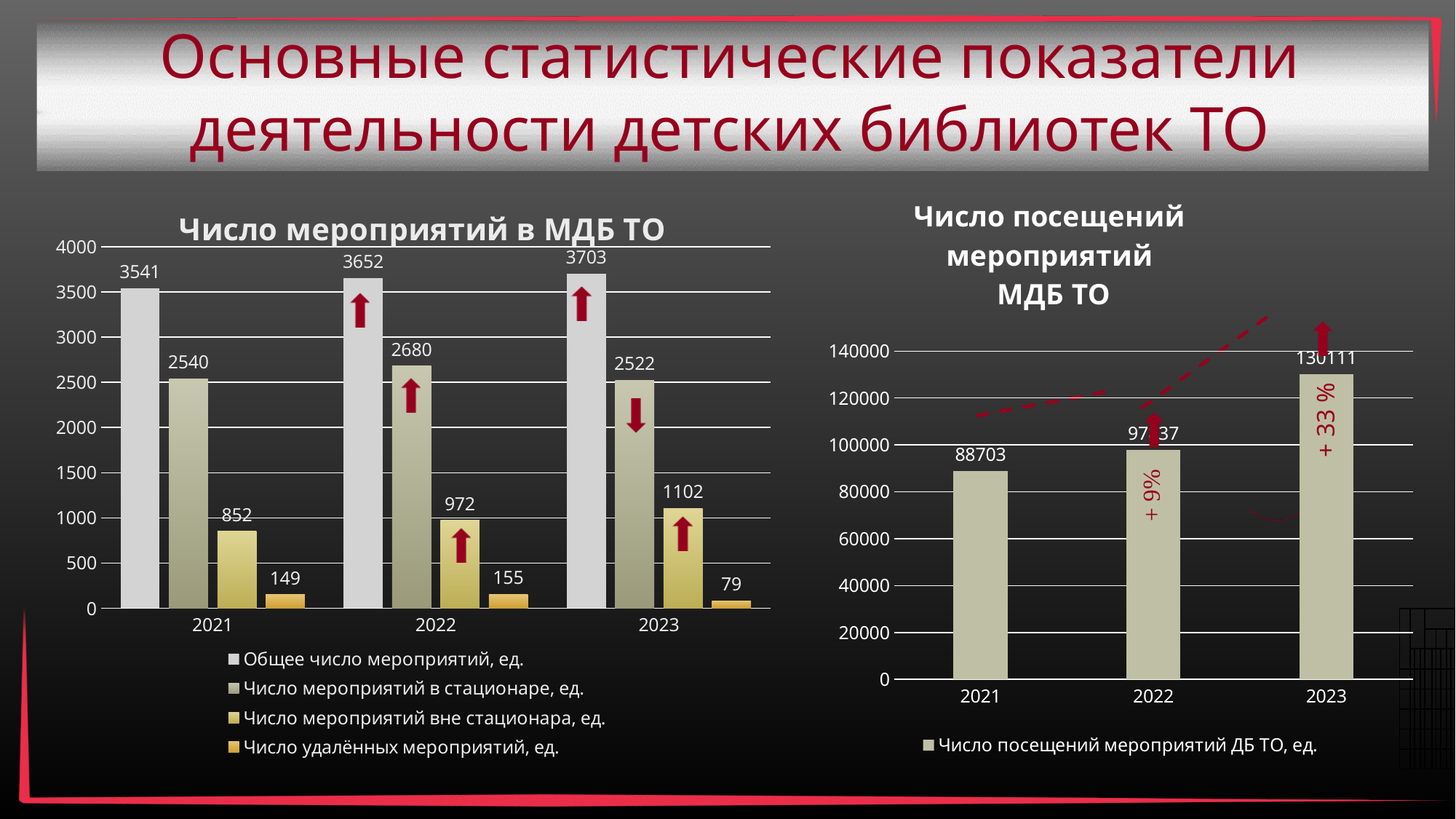
In the chart 'Число мероприятий в МДБ ТО', which year has the larger value for 'Число мероприятий в стационаре, ед.': 2022 or 2023? 2022 What kind of chart is 'Число посещений мероприятий МДБ ТО'? bar chart In the chart 'Число мероприятий в МДБ ТО', what is the value of 'Число мероприятий вне стационара, ед.' for 2023? 1102 In the chart 'Число мероприятий в МДБ ТО', what is the value of 'Число удалённых мероприятий, ед.' for 2023? 79 In the chart 'Число мероприятий в МДБ ТО', which year has the lowest value for 'Число удалённых мероприятий, ед.'? 2023 In the chart 'Число мероприятий в МДБ ТО', which year has the highest value for 'Общее число мероприятий, ед.'? 2023 How many series does the legend of the chart 'Число мероприятий в МДБ ТО' list? 4 In the chart 'Число посещений мероприятий МДБ ТО', what is the value for 2021? 88703 In the chart 'Число мероприятий в МДБ ТО', what is the difference between 'Общее число мероприятий, ед.' in 2023 and in 2022? 51 In the chart 'Число посещений мероприятий МДБ ТО', is the value for 2023 greater or less than 120000? greater In the chart 'Число мероприятий в МДБ ТО', do the values for 'Число мероприятий вне стационара, ед.' rise or fall from 2021 to 2023? rise In the chart 'Число мероприятий в МДБ ТО', what is the value of 'Общее число мероприятий, ед.' for 2021? 3541